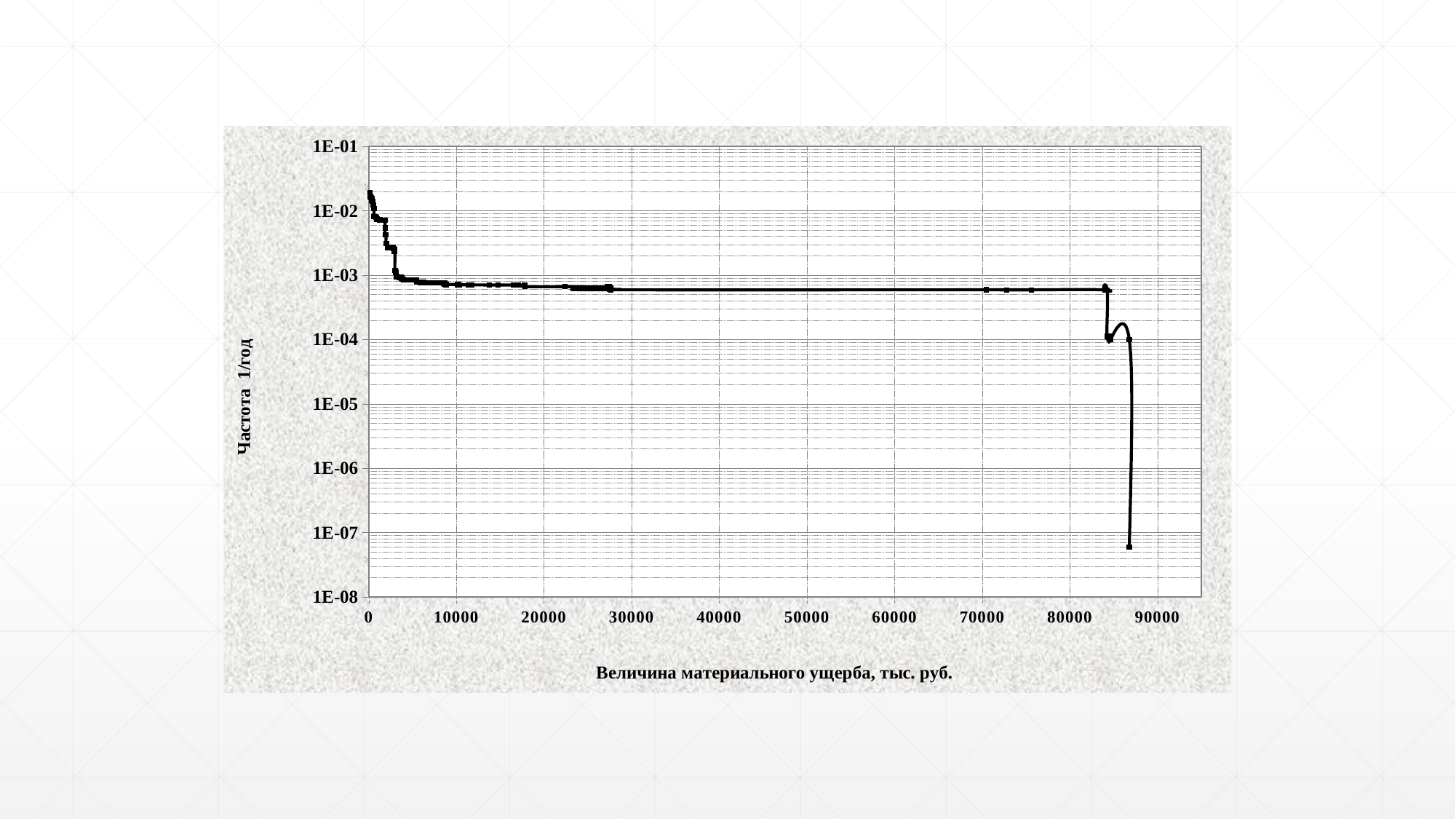
What is the label of the x axis? Величина материального ущерба, тыс. руб. Is the frequency value at a damage of 50000 greater or less than 1E-04? greater Is the frequency value at a damage of 0 greater or less than 1E-02? greater What kind of chart is shown on the slide? line chart Which is larger: the frequency value at a damage of 0 or at a damage of 80000? at a damage of 0 What is the label of the y axis? Частота 1/год What is the highest tick value shown on the y axis? 1E-01 Is the frequency value at a damage of 20000 greater or less than 1E-02? less Do the plotted frequency values rise or fall as the damage value increases along the x axis? fall